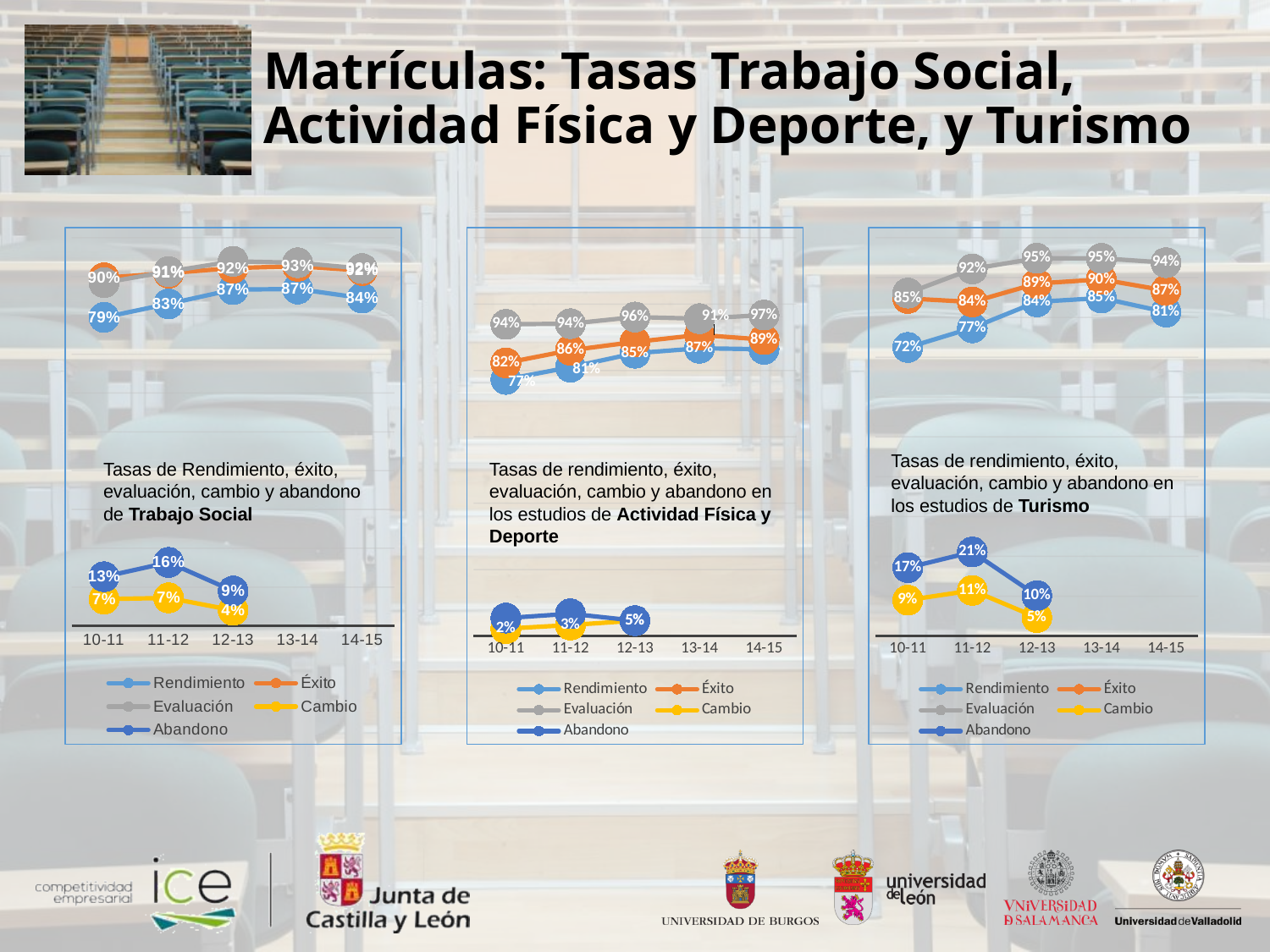
In the Turismo chart, what is the difference between the Abandono values for 11-12 and 12-13? 11 percentage points In the Turismo chart, what is the Rendimiento value for 10-11? 72% In the Trabajo Social chart, what is the Rendimiento value for 10-11? 79% What kind of chart is the Trabajo Social chart? Line chart How many academic years are shown on the x axis of the Turismo chart? 5 In the Trabajo Social chart, which is larger for 11-12: Abandono or Cambio? Abandono In the Trabajo Social chart, in which year is the Cambio value lowest? 12-13 In the Turismo chart, in which year is the Abandono value highest? 11-12 How many series does the legend of the Actividad Física y Deporte chart list? 5 In the Turismo chart, what is the Abandono value for 11-12? 21% In the Actividad Física y Deporte chart, what is the Abandono value for 12-13? 5% In the Turismo chart, does the Rendimiento value rise or fall from 10-11 to 12-13? Rise